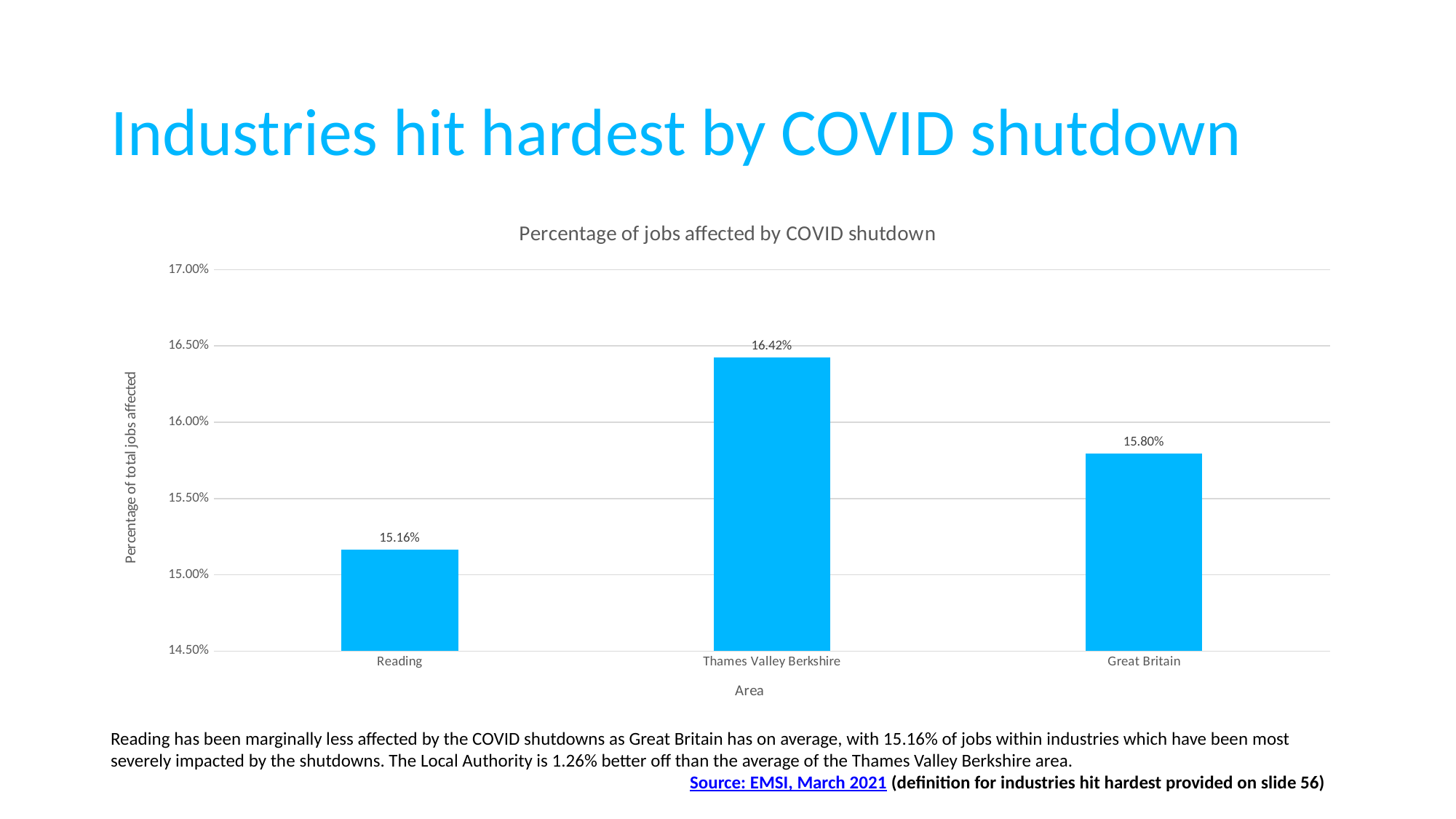
What is the value for Great Britain? 15.80% What is the title of the chart? Percentage of jobs affected by COVID shutdown How many areas are shown in the chart? 3 What is the difference between the values for Thames Valley Berkshire and Reading? 1.26% What is the value for Thames Valley Berkshire? 16.42% Is the value for Thames Valley Berkshire greater or less than 16.00%? greater What is the value for Reading? 15.16% Which area has the lowest percentage of jobs affected? Reading What kind of chart is shown on the slide? Bar chart Which is larger, the value for Great Britain or the value for Reading? Great Britain Which area has the highest percentage of jobs affected? Thames Valley Berkshire What is the difference between the values for Great Britain and Reading? 0.64%